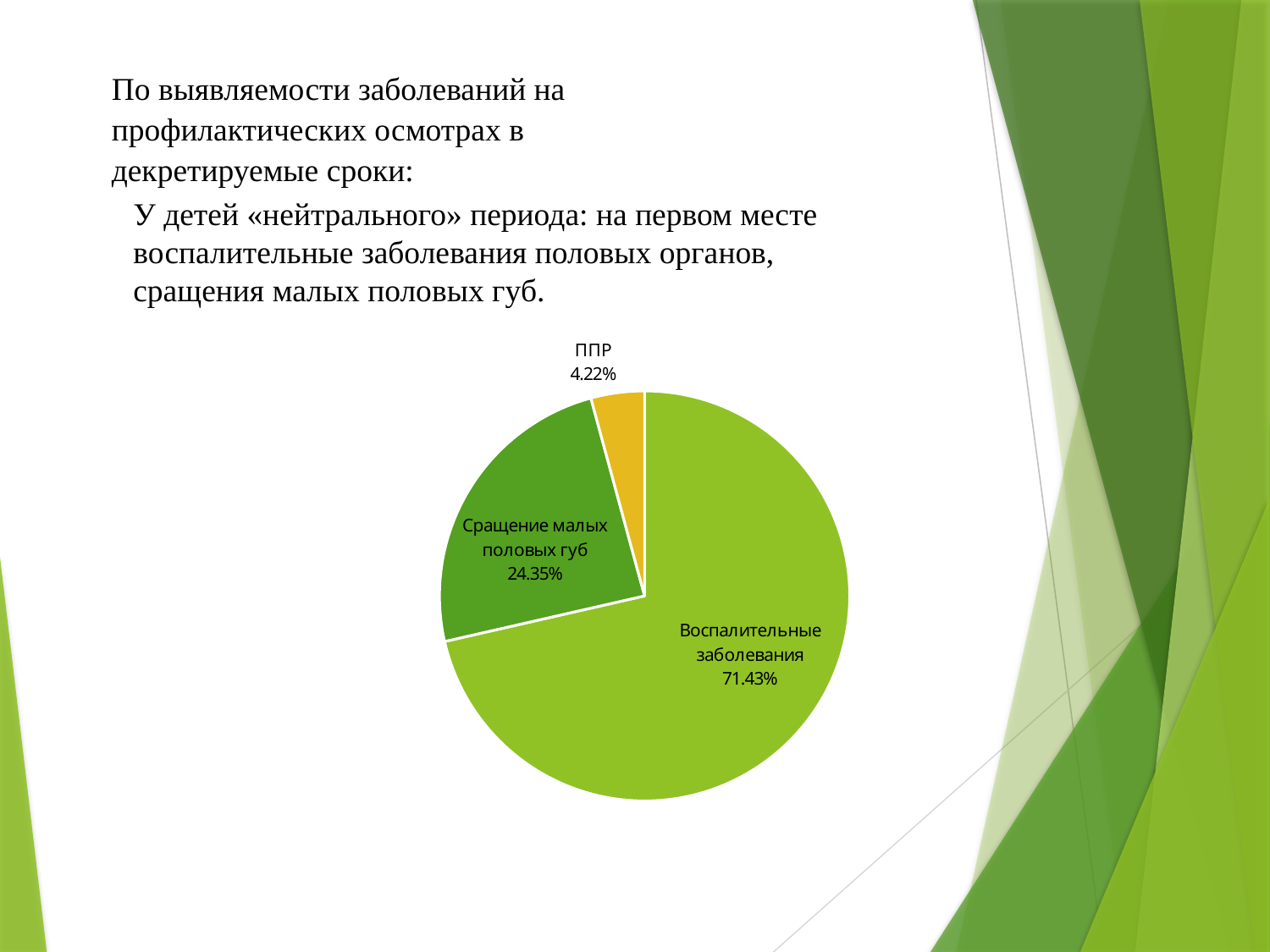
Which slice of the pie is the smallest? ППР What is the difference in percentage points between Воспалительные заболевания and Сращение малых половых губ? 47.08 What share of the pie does ППР have? 4.22% What colour is the ППР slice? yellow What kind of chart is shown on the slide? pie chart Is the share for Воспалительные заболевания greater or less than 50%? greater What is the difference in percentage points between Сращение малых половых губ and ППР? 20.13 What share of the pie does Воспалительные заболевания have? 71.43% Which is larger, the slice for Сращение малых половых губ or the slice for ППР? Сращение малых половых губ Which slice of the pie is the largest? Воспалительные заболевания How many slices does the pie chart have? 3 What share of the pie does Сращение малых половых губ have? 24.35%